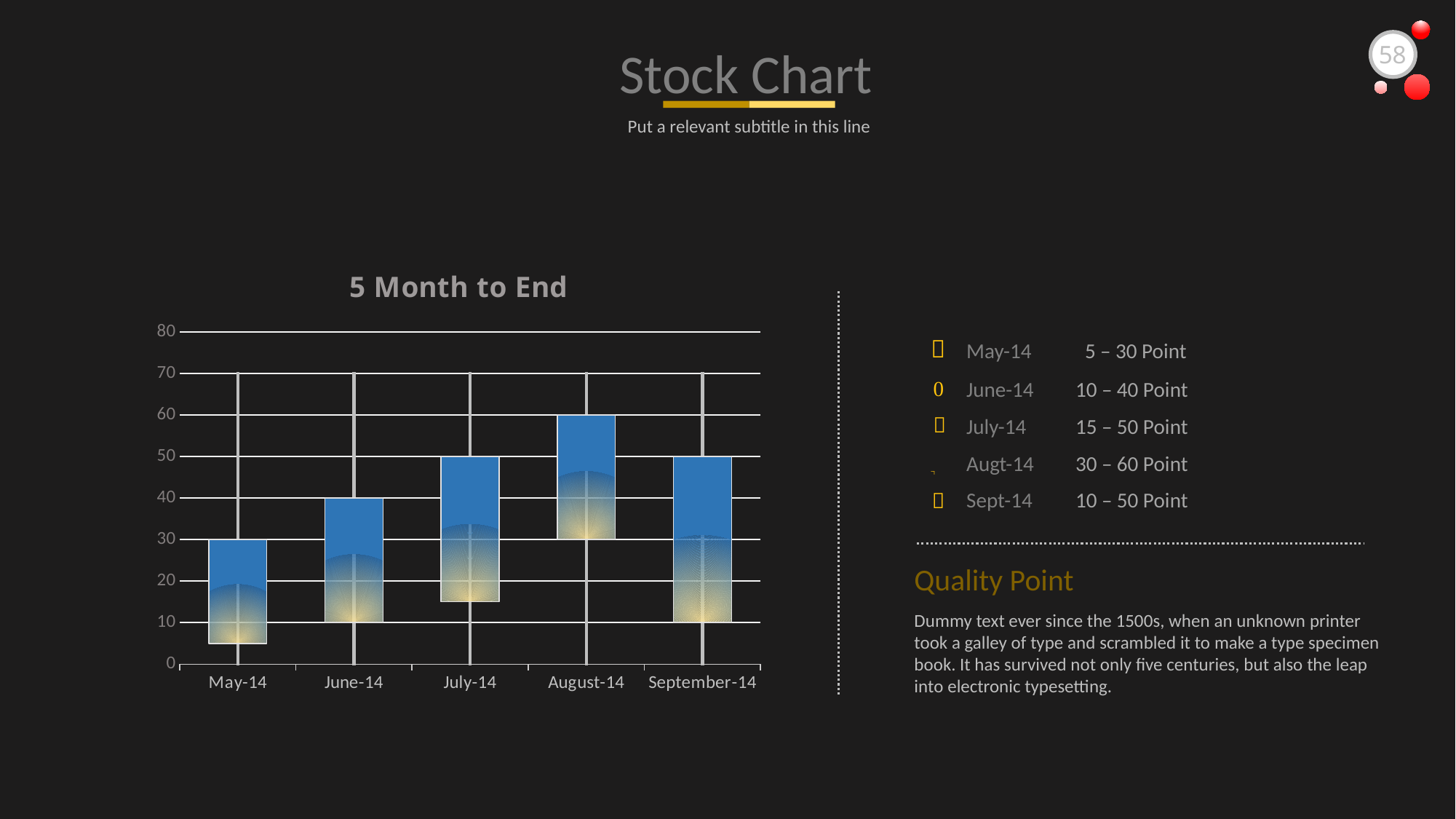
What value does the top of the August-14 box reach? 60 Is the top of the July-14 box greater or less than 40? greater Do the box tops rise or fall from May-14 to August-14? rise Which box has a higher top value, June-14 or September-14? September-14 According to the text on the right, what is the point range for Augt-14? 30 – 60 Point What is the title of the chart? 5 Month to End What value does the top of the September-14 box reach? 50 Which month has the box with the lowest bottom value? May-14 Is the bottom of the August-14 box greater or less than 20? greater How many months are shown on the x axis of the chart? 5 Which month has the box with the highest top value? August-14 What value does the bottom of the June-14 box sit at? 10